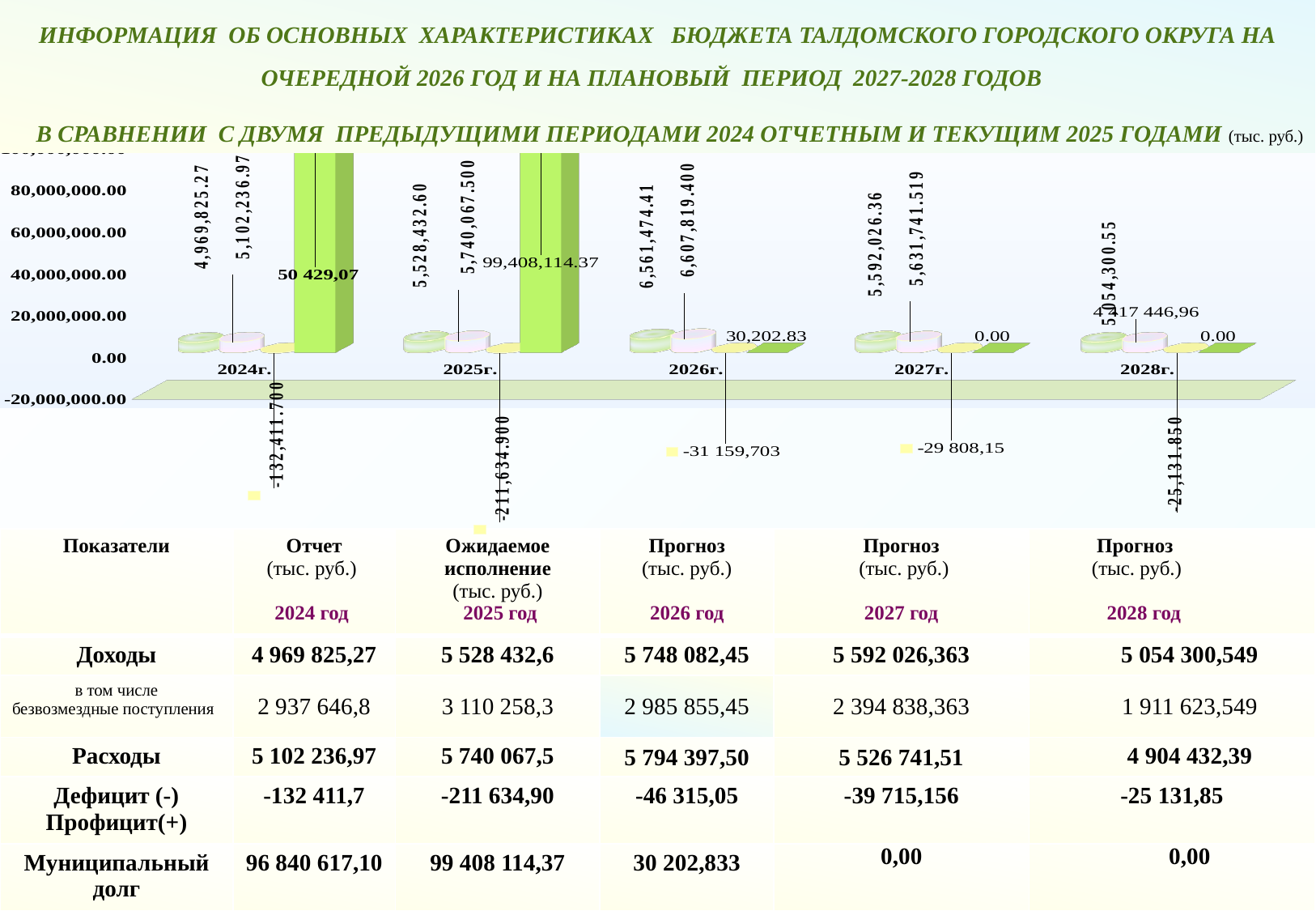
What value is printed on the tallest bar for 2025г. in the chart? 99,408,114.37 What value is printed next to the rightmost bar for 2027г. in the chart? 0.00 What negative value is labelled below the axis for 2025г. in the chart? -211,634.900 How many year categories are shown along the x axis of the chart? 5 What value is printed next to the rightmost bar for 2026г. in the chart? 30,202.83 What is the difference between the second label (5,102,236.97) and the first label (4,969,825.27) for 2024г. in the chart? 132,411.70 What kind of chart is shown on the slide? bar chart What negative value is labelled below the axis for 2024г. in the chart? -132,411.700 What is the first (leftmost) data label printed above the 2024г. group in the chart? 4,969,825.27 Is the tallest bar for 2025г. greater or less than 80,000,000.00? greater What is the second data label printed above the 2025г. group in the chart? 5,740,067.500 What negative value is labelled below the axis for 2028г. in the chart? -25,131.850